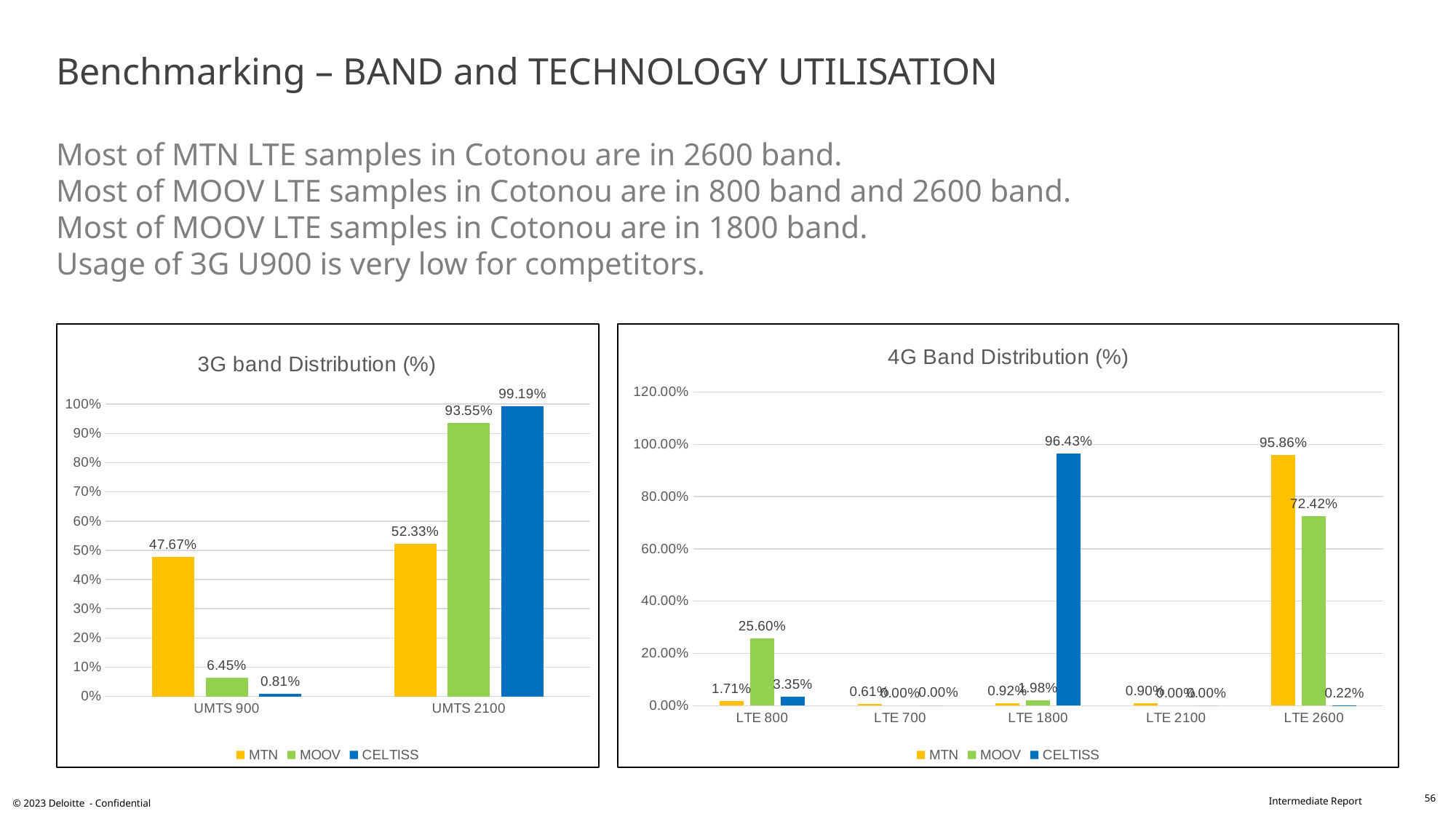
In the 3G band Distribution (%) chart, how many series does the legend list? 3 In the 3G band Distribution (%) chart, which operator has the highest value in UMTS 2100? CELTISS In the 3G band Distribution (%) chart, what is the difference between MTN's UMTS 2100 and UMTS 900 values? 4.66% In the 3G band Distribution (%) chart, what is the value for CELTISS in UMTS 2100? 99.19% In the 4G Band Distribution (%) chart, how many LTE band categories are shown on the x axis? 5 In the 4G Band Distribution (%) chart, is the value for MTN in LTE 2600 greater or less than MOOV in LTE 2600? greater In the 4G Band Distribution (%) chart, what is the value for MOOV in LTE 800? 25.60% What kind of chart is the 4G Band Distribution (%) chart? Bar chart In the 3G band Distribution (%) chart, what is the value for MTN in UMTS 900? 47.67% In the 3G band Distribution (%) chart, which operator has the lowest value in UMTS 900? CELTISS In the 4G Band Distribution (%) chart, what is the value for CELTISS in LTE 1800? 96.43% In the 4G Band Distribution (%) chart, which operator has the highest value in LTE 2600? MTN